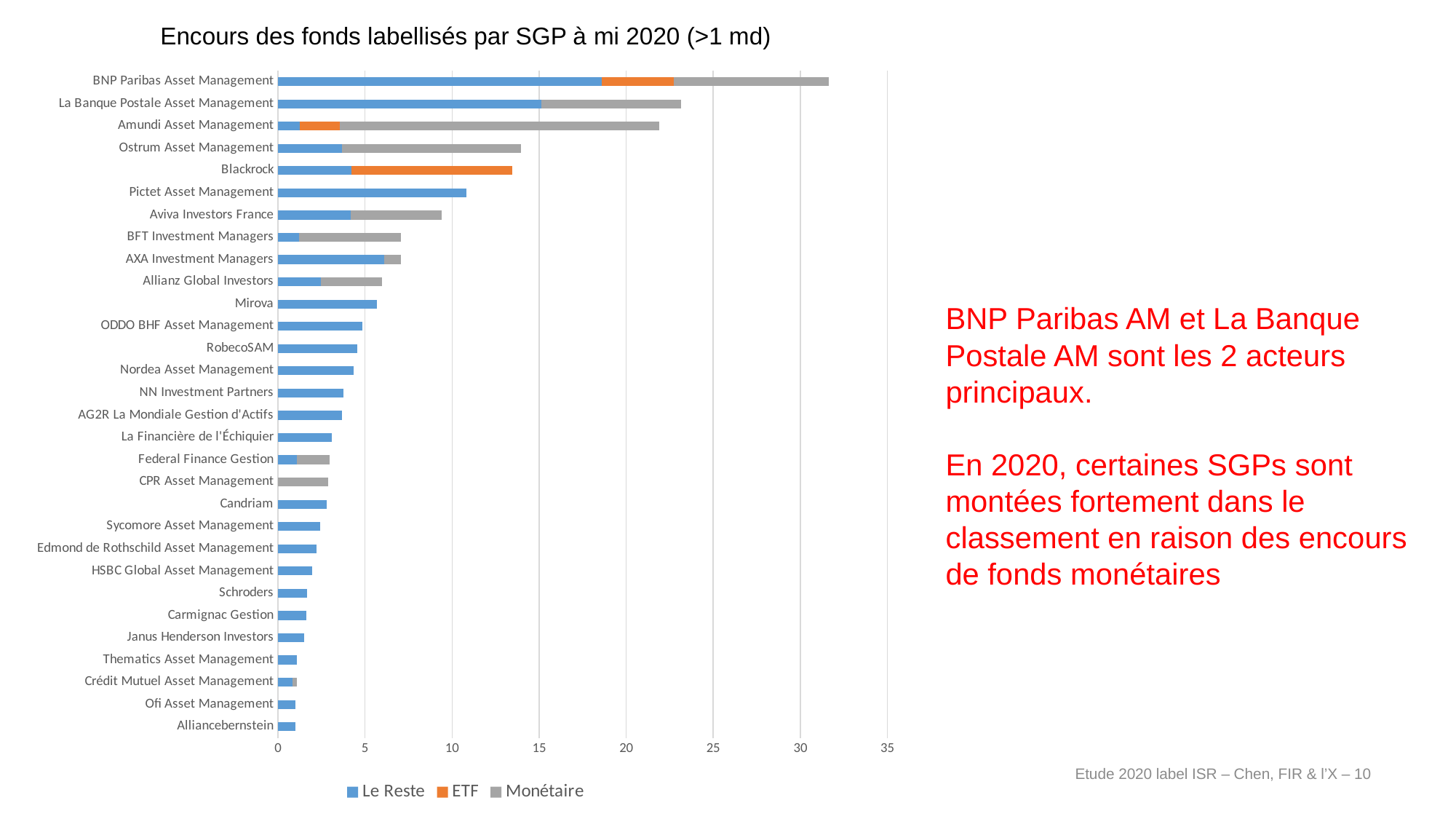
Which has the larger total bar, Blackrock or Pictet Asset Management? Blackrock How many asset managers (categories) are plotted on the chart? 30 What is the title of the chart? Encours des fonds labellisés par SGP à mi 2020 (>1 md) What kind of chart is shown on the slide? Stacked bar chart Is the total value for BNP Paribas Asset Management greater or less than 30? greater Is the total value for Aviva Investors France greater or less than 10? less Is the total value for Ostrum Asset Management greater or less than 15? less Which asset manager has the highest total bar? BNP Paribas Asset Management How many series does the legend list? 3 Which series is shown in orange in the legend? ETF